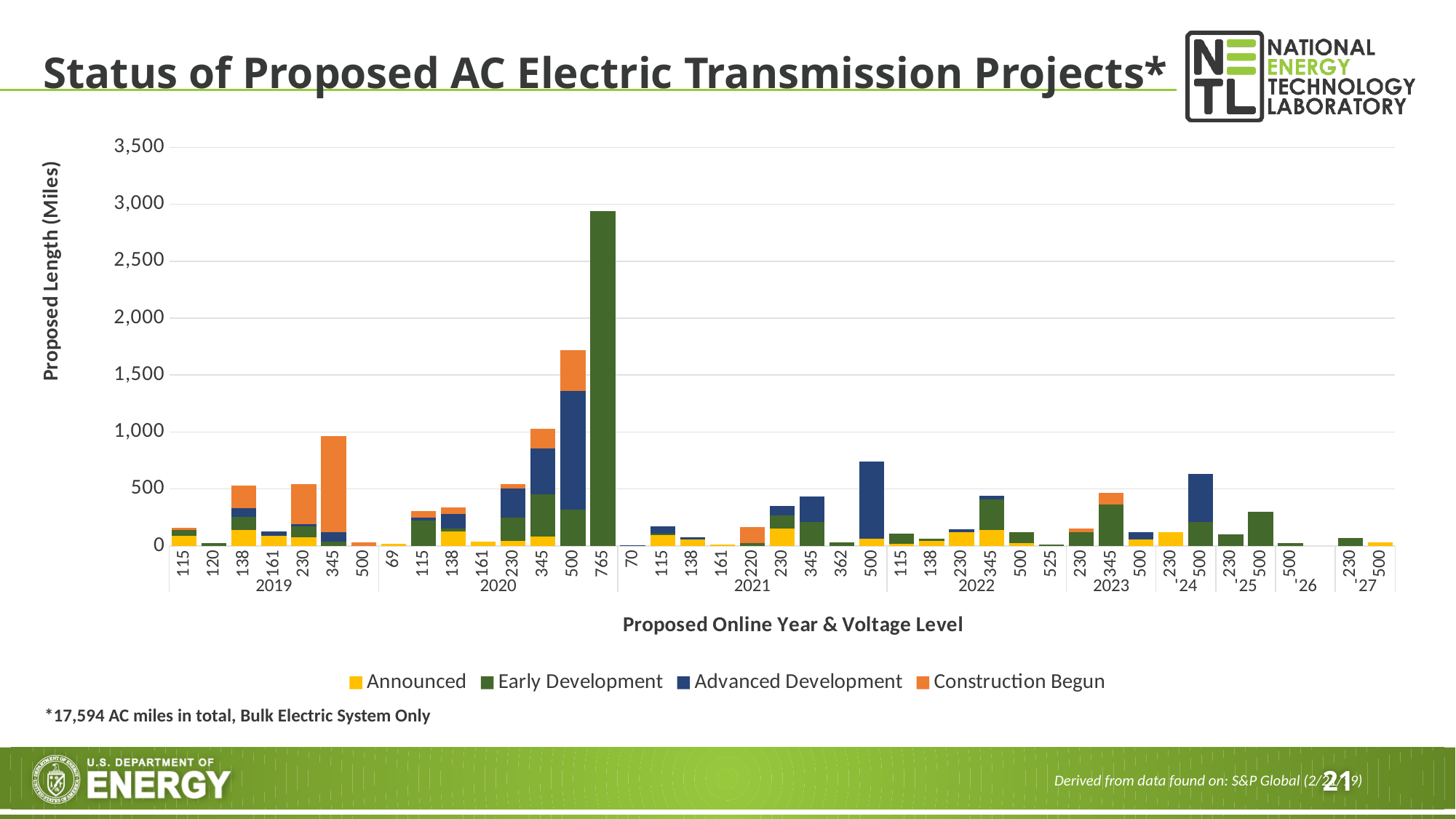
How many series does the legend list? 4 What kind of chart is shown on the slide? Stacked bar chart Is the total for the 345 kV bar in 2019 greater or less than 500? greater Which series makes up the 765 kV bar in 2020? Early Development Is the total for the 500 kV bar in 2021 greater or less than 500? greater Which is larger, the 345 kV bar in 2019 or the 230 kV bar in 2019? 345 kV bar in 2019 What is the title of the vertical axis? Proposed Length (Miles) Which is larger, the 765 kV bar in 2020 or the 500 kV bar in 2020? 765 kV bar in 2020 How many voltage-level bars are shown for 2021? 9 Is the total for the 500 kV bar in 2020 greater or less than 1,500? greater Which year and voltage level has the tallest bar? 2020, 765